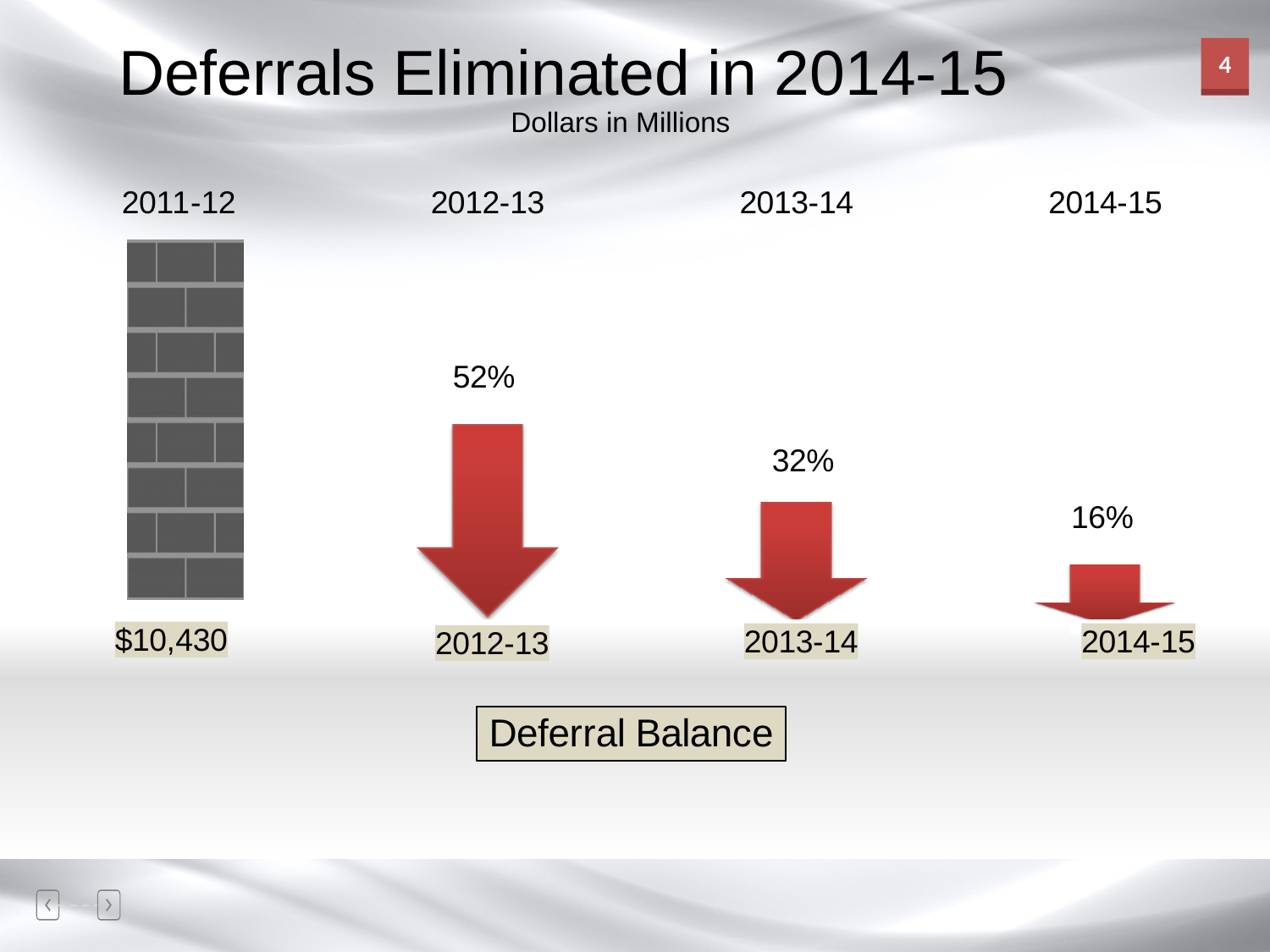
Which year has the highest percentage shown above its arrow? 2012-13 Which year has the lowest percentage shown above its arrow? 2014-15 Which is larger, the percentage for 2013-14 or the percentage for 2014-15? 2013-14 What percentage is shown above the arrow for 2012-13? 52% In what units are the dollar values on the slide expressed, according to the subtitle? Dollars in Millions What is the difference in percentage points between the 2012-13 value and the 2013-14 value? 20 percentage points What percentage is shown above the arrow for 2014-15? 16% What is the deferral balance shown for 2011-12? $10,430 What percentage is shown above the arrow for 2013-14? 32% Do the percentages rise or fall from 2012-13 to 2014-15? fall What is the difference in percentage points between the 2013-14 value and the 2014-15 value? 16 percentage points How many fiscal years are shown across the chart? 4